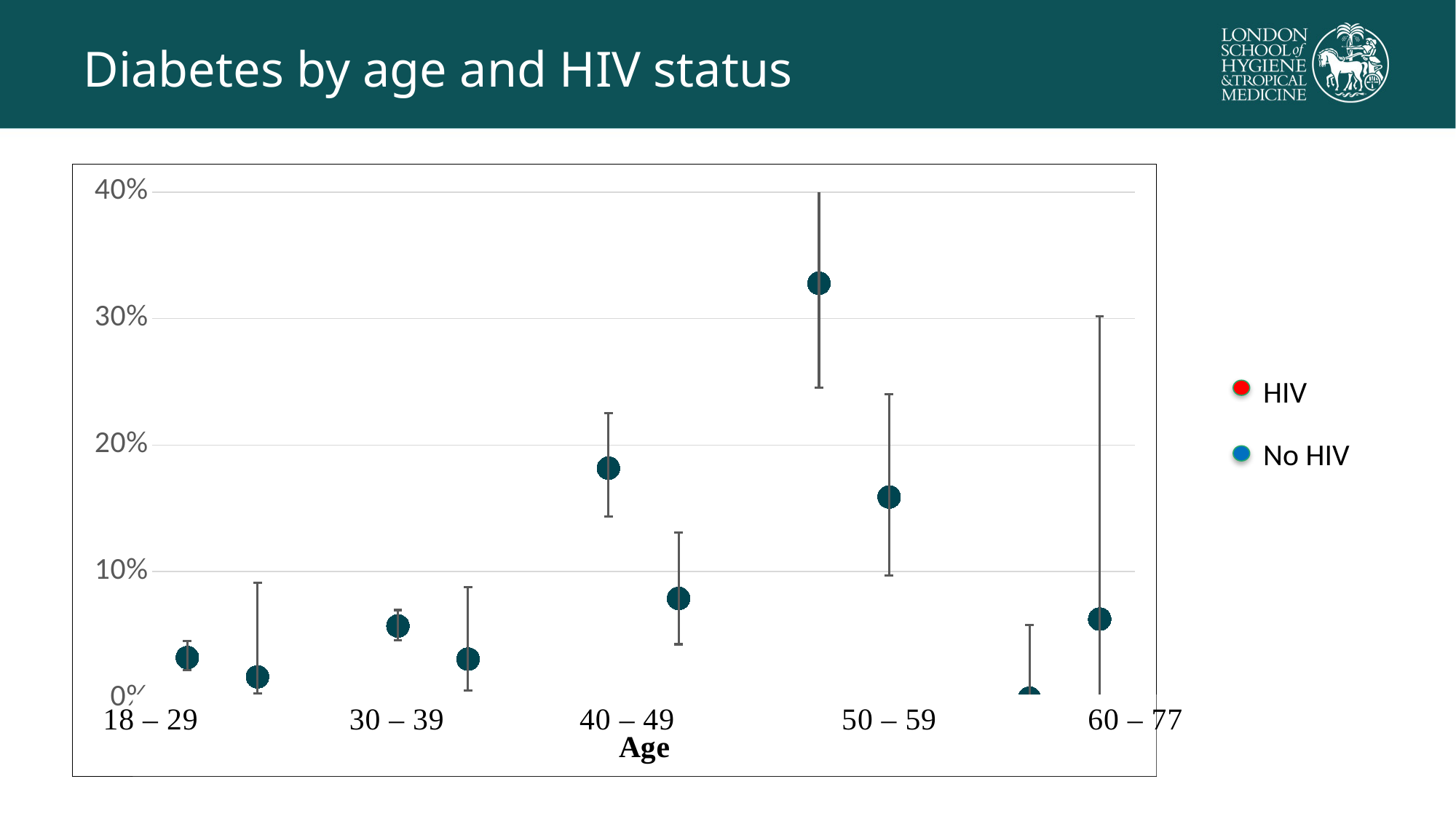
How many series does the chart legend list? 2 How many age groups are shown on the x axis of the chart? 5 Is the left-hand point in the 40 – 49 age group greater or less than 10%? greater Is the left-hand point in the 18 – 29 age group greater or less than 10%? less What are the two entries in the chart legend? HIV and No HIV What is the title of the chart? Diabetes by age and HIV status Which age group contains the highest plotted point? 50 – 59 Is the right-hand point in the 60 – 77 age group greater or less than 10%? less What kind of chart is shown on the slide? Scatter chart with error bars Which is larger: the left-hand point in the 40 – 49 age group or the right-hand point in the 40 – 49 age group? The left-hand point